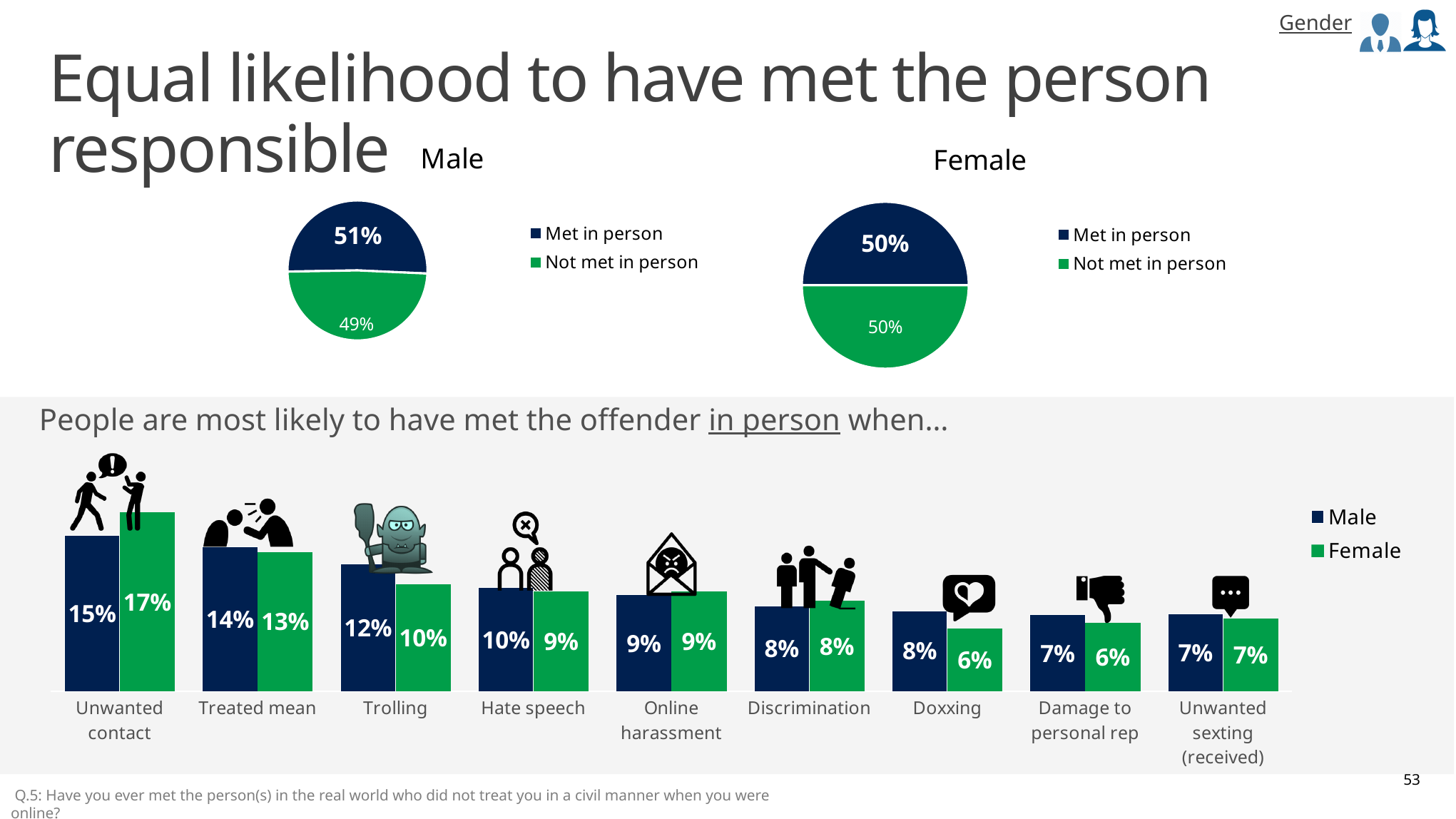
How many categories are shown on the x axis of the bottom bar chart? 9 In the Female pie chart, what share of respondents had not met the person in person? 50% In the bottom bar chart, which is larger for Treated mean: the Male value or the Female value? Male What kind of chart is the bottom chart on the slide? Bar chart In the Male pie chart, what is the value for 'Not met in person'? 49% In the bottom bar chart, what is the Male value for Trolling? 12% In the bottom bar chart, which category has the highest Female value? Unwanted contact In the bottom bar chart, what is the Female value for Unwanted contact? 17% In the bottom bar chart, what is the difference between the Male and Female values for Doxxing? 2% In the Male pie chart, what share of respondents had met the person in person? 51% How many entries does the legend of the Female pie chart list? 2 In the bottom bar chart, do the Male values generally rise or fall from left to right? Fall